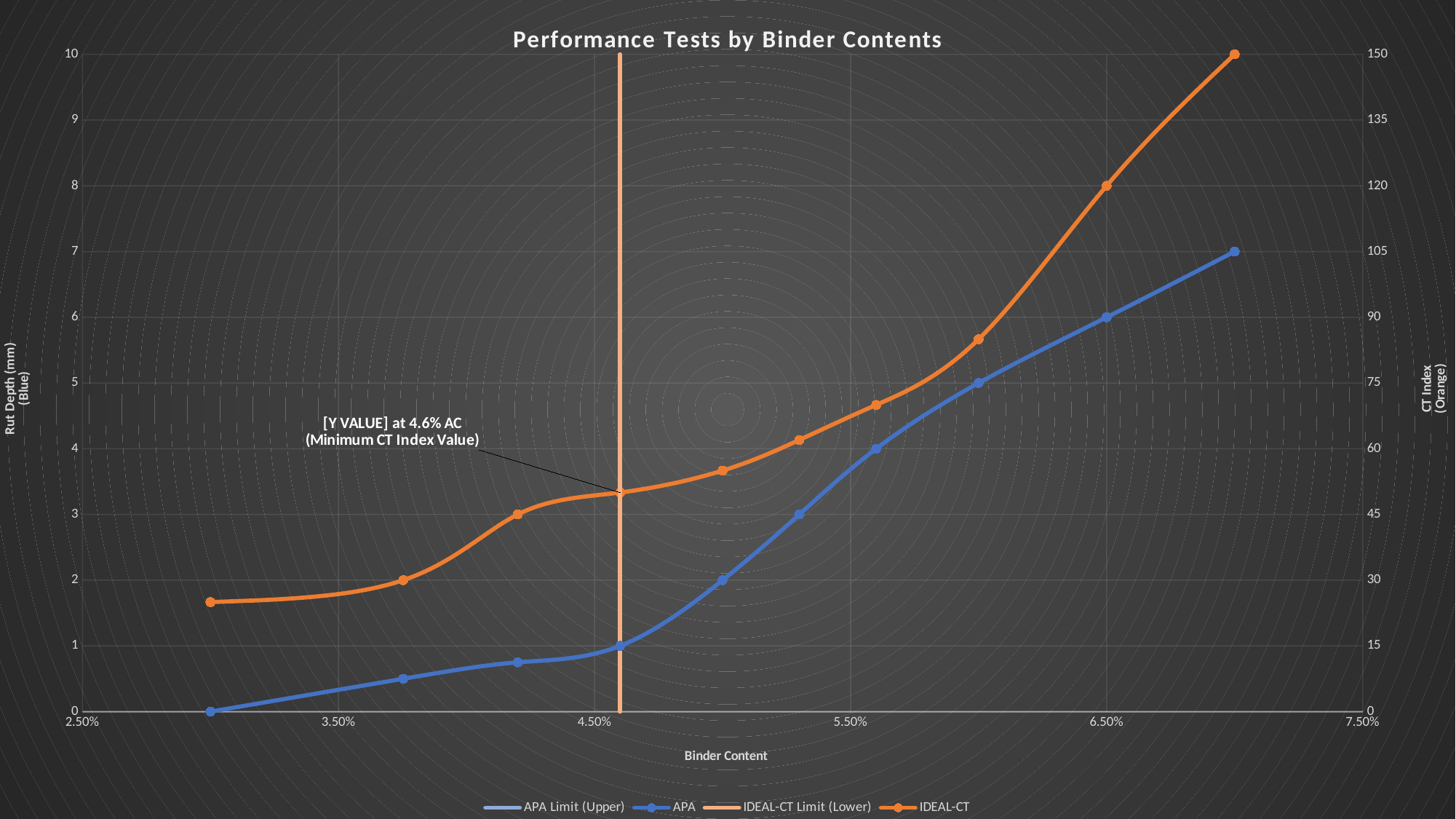
How many series does the legend list? 4 What is the highest CT Index value reached by the IDEAL-CT series? 150 What kind of chart is shown on the slide? Line chart What is the lowest rut depth value of the APA series? 0 What is the APA rut depth value at 4.6% AC, where the IDEAL-CT Limit (Lower) line is drawn? 1 What is the APA rut depth value at 6.50% binder content? 6 What is the highest rut depth value reached by the APA series? 7 Do the IDEAL-CT values rise or fall as binder content increases? Rise Is the IDEAL-CT index value at 4.6% AC greater or less than 60? less How many data points are plotted for the APA series? 10 What is the IDEAL-CT index value at 6.50% binder content? 120 What is the title of the chart? Performance Tests by Binder Contents